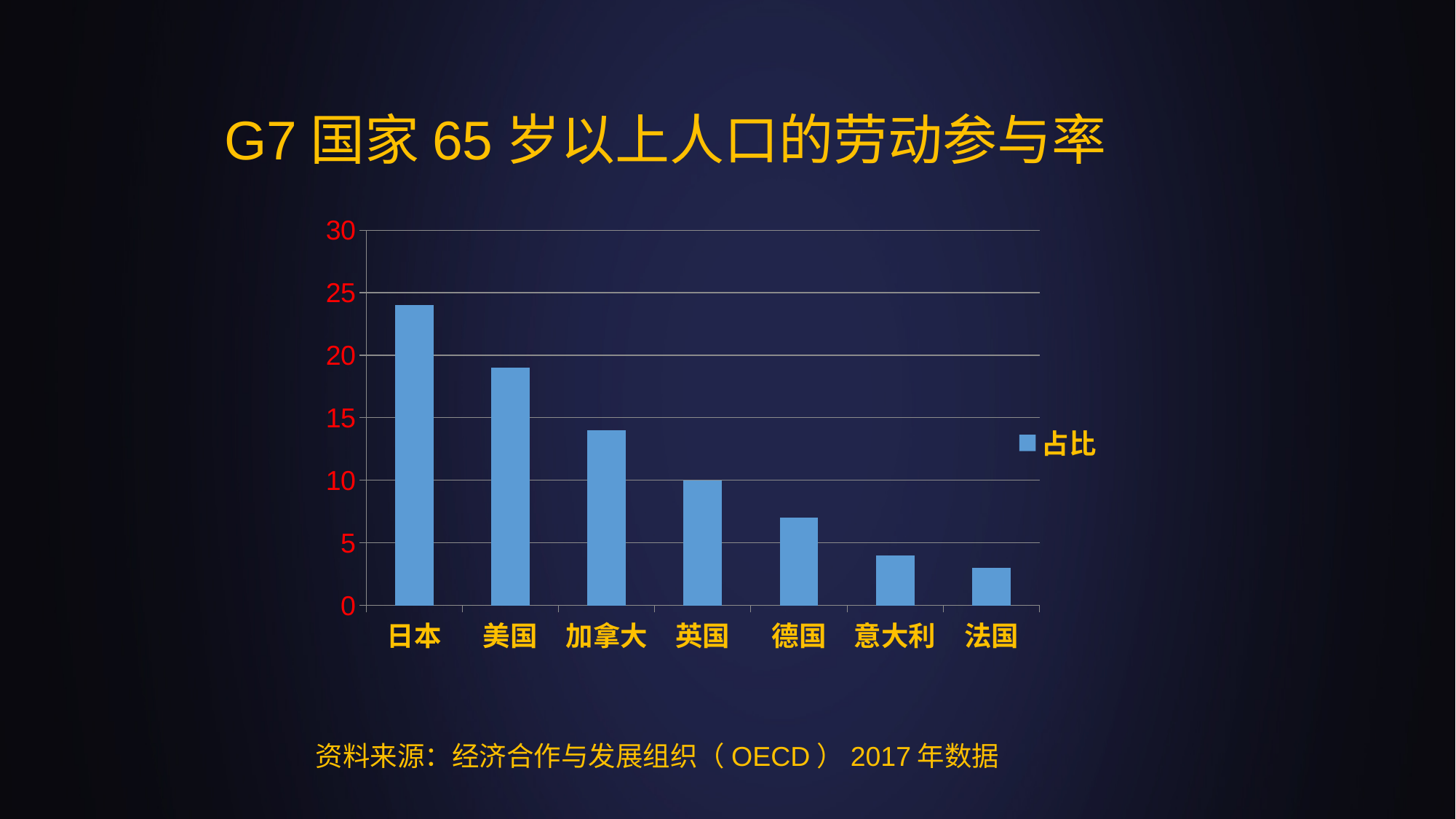
Do the values rise or fall from left to right along the x axis? fall Is the value for 德国 greater or less than 5? greater Which country has the highest value in the chart? 日本 What is the value for 英国? 10 How many countries are shown on the x axis of the chart? 7 Is the value for 日本 greater or less than 20? greater Which is larger, the value for 加拿大 or the value for 德国? 加拿大 How many series does the legend list? 1 What kind of chart is shown on the slide? bar chart What is the title of the chart? G7 国家 65 岁以上人口的劳动参与率 Is the value for 美国 greater or less than 20? less Which country has the lowest value in the chart? 法国